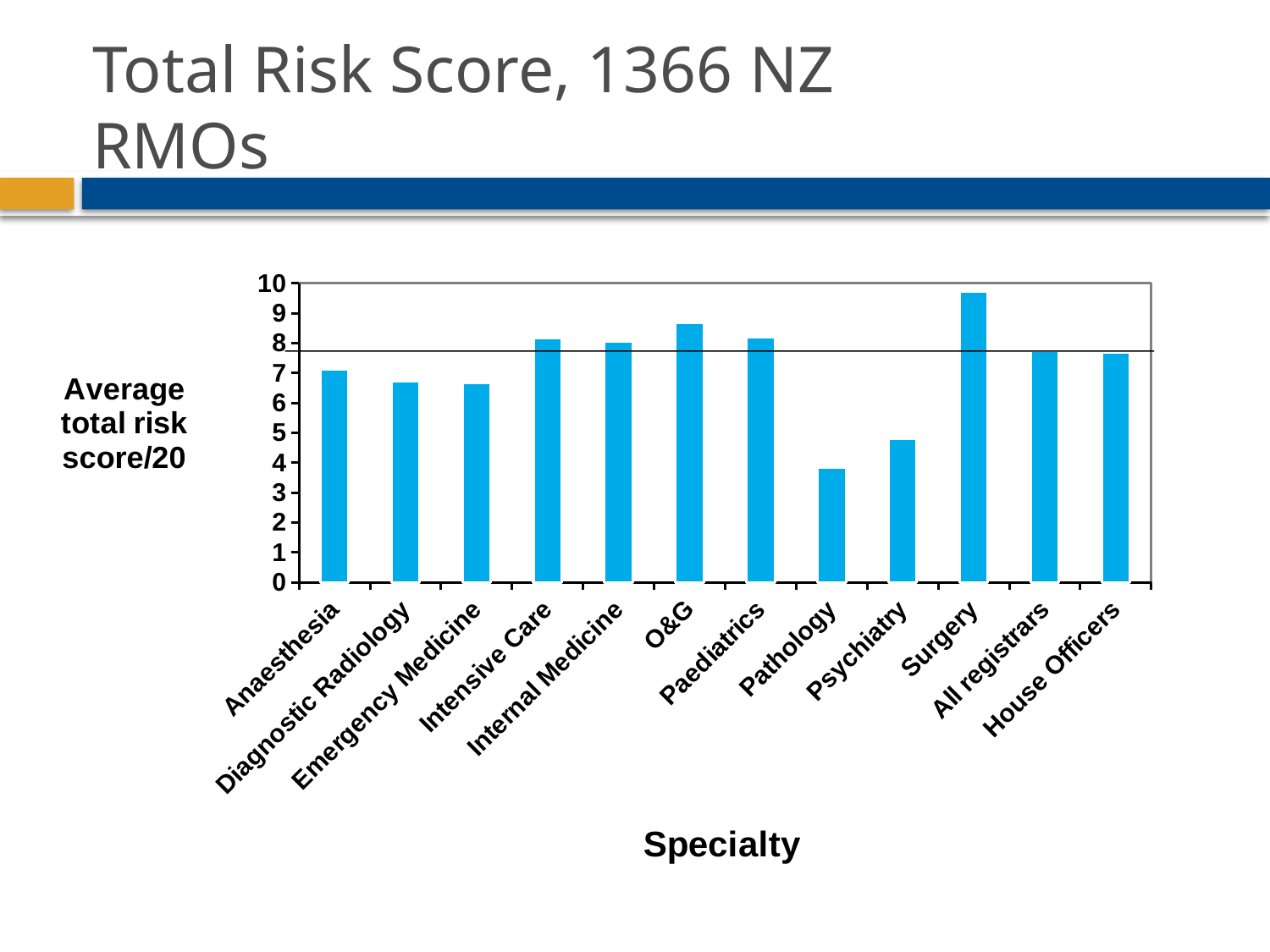
How many specialties are plotted on the x axis? 12 What kind of chart is shown on the slide? bar chart Is the value for Psychiatry greater or less than 5? less Which specialty has the highest average total risk score? Surgery Is the value for Surgery greater or less than 9? greater Is the value for Pathology greater or less than 4? less What is the title of the x axis? Specialty Which has a higher average total risk score, O&G or Psychiatry? O&G Which specialty has the lowest average total risk score? Pathology Which has a higher average total risk score, Pathology or Anaesthesia? Anaesthesia